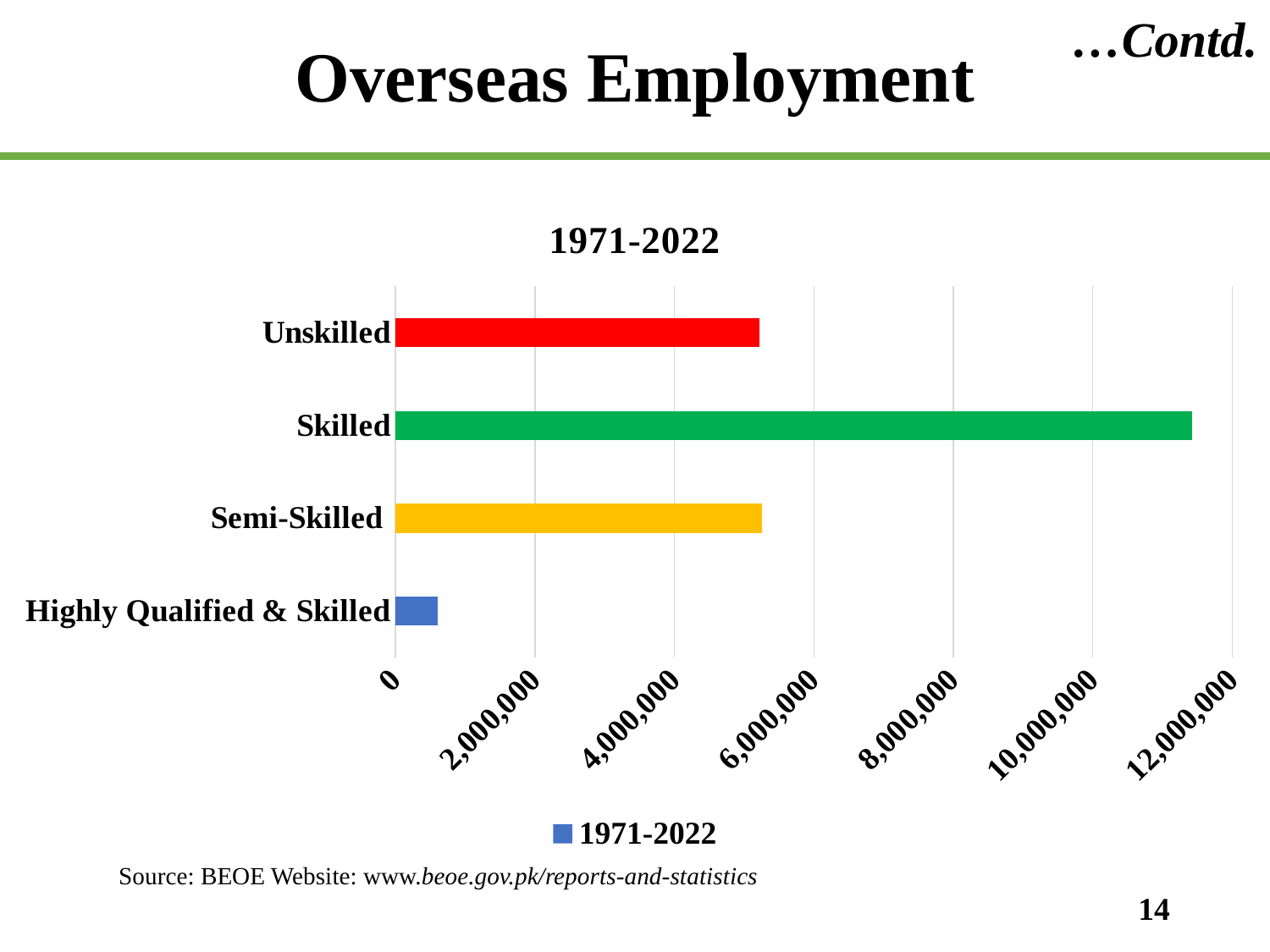
Which category has the highest value? Skilled What is the title of the chart? 1971-2022 How many categories are plotted in the chart? 4 Which category has the lowest value? Highly Qualified & Skilled Is the value for Skilled greater or less than 10,000,000? greater Is the value for Semi-Skilled greater or less than 4,000,000? greater Which is larger, the value for Skilled or the value for Unskilled? Skilled How many series does the legend list? 1 What kind of chart is shown on the slide? Bar chart Is the value for Highly Qualified & Skilled greater or less than 2,000,000? less What colour is the bar for Skilled? Green